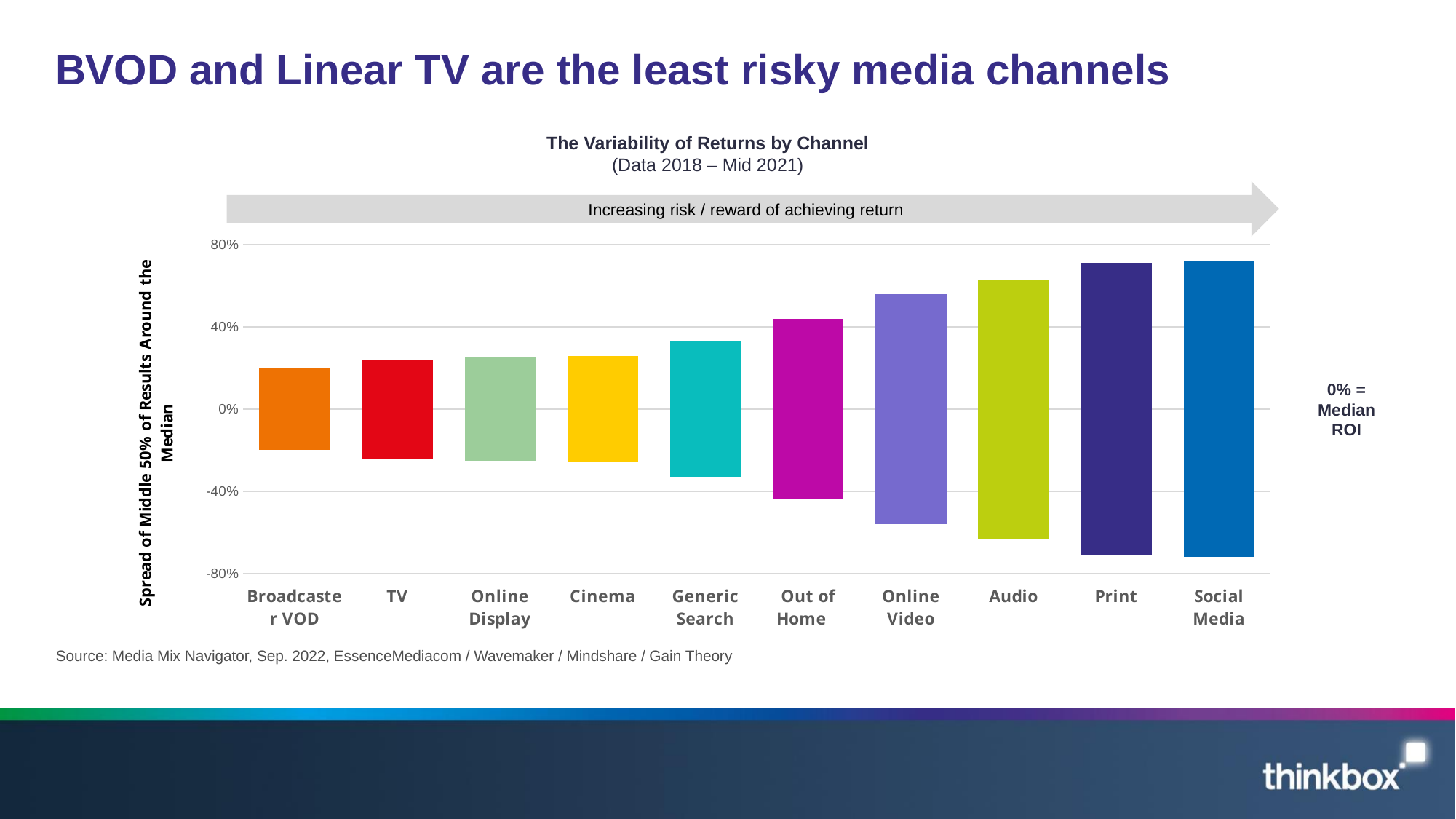
What is the title of the chart? The Variability of Returns by Channel Is the upper end of the Generic Search bar greater or less than 40%? less Does the spread of results increase or decrease moving from left to right across the channels? increase Which channel has a wider spread of results, Cinema or Out of Home? Out of Home Is the upper end of the Online Video bar greater or less than 40%? greater Is the lower end of the Audio bar greater or less than -40%? less Which channel has the narrowest spread of results around the median? Broadcaster VOD What kind of chart is shown on the slide? bar chart How many media channels are plotted on the chart? 10 What does the label to the right of the chart say 0% represents? Median ROI